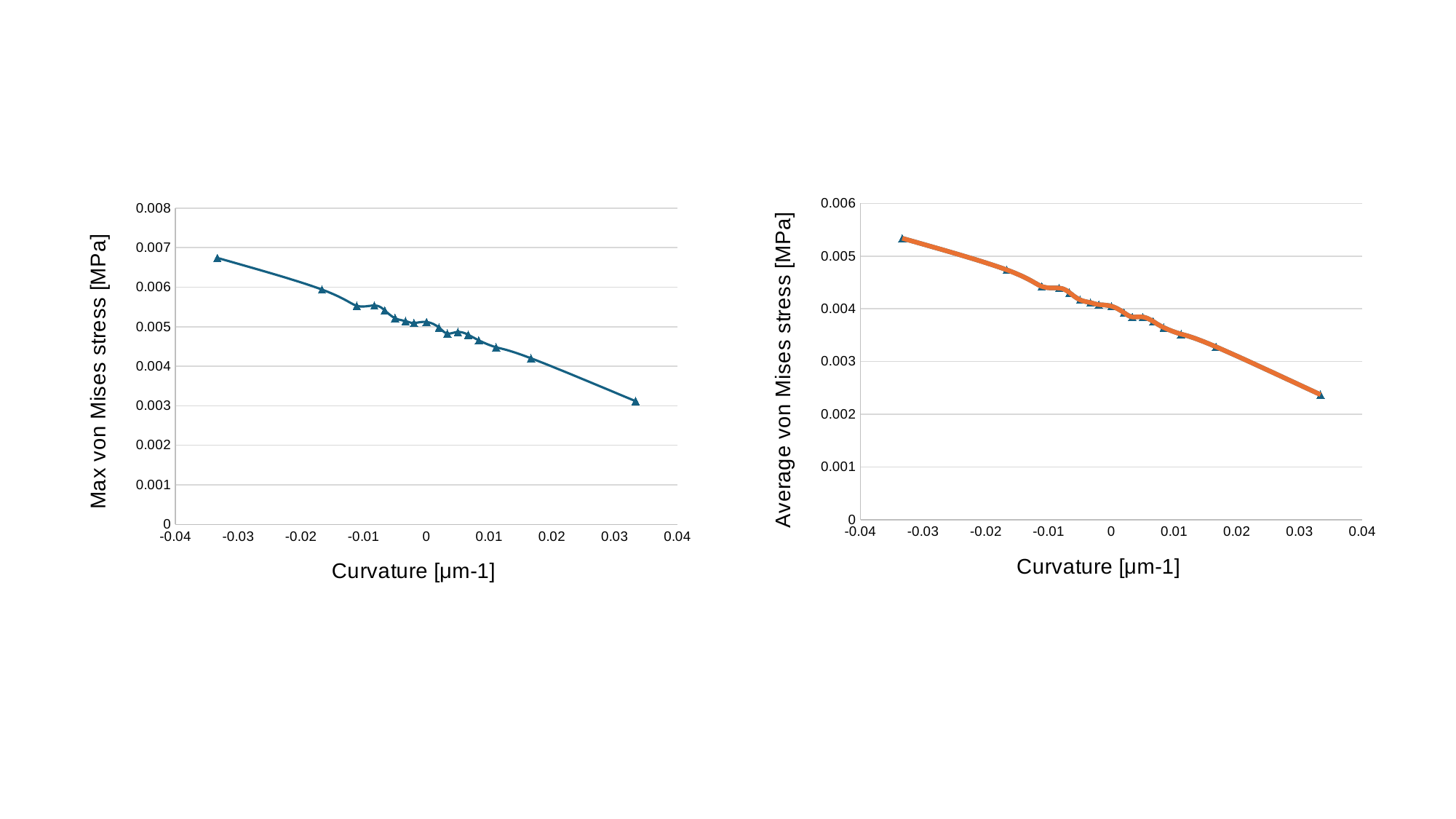
What is the label of the x axis on the left chart? Curvature [µm-1] In the left chart (Max von Mises stress), do the values rise or fall as curvature increases from -0.04 to 0.04? fall In the right chart (Average von Mises stress), is the value at the rightmost point (curvature about 0.033) greater or less than 0.003? less In the left chart (Max von Mises stress), is the value at the rightmost point (curvature about 0.033) greater or less than 0.004? less What kind of chart is the right chart, showing Average von Mises stress against Curvature? line chart What is the label of the y axis on the right chart? Average von Mises stress [MPa] In the right chart (Average von Mises stress), is the value at the leftmost point (curvature about -0.033) greater or less than 0.005? greater What kind of chart is the left chart, showing Max von Mises stress against Curvature? line chart In the right chart (Average von Mises stress), do the values rise or fall as curvature increases along the x axis? fall In the right chart (Average von Mises stress), which is larger: the value at curvature -0.033 or the value at curvature 0.033? the value at curvature -0.033